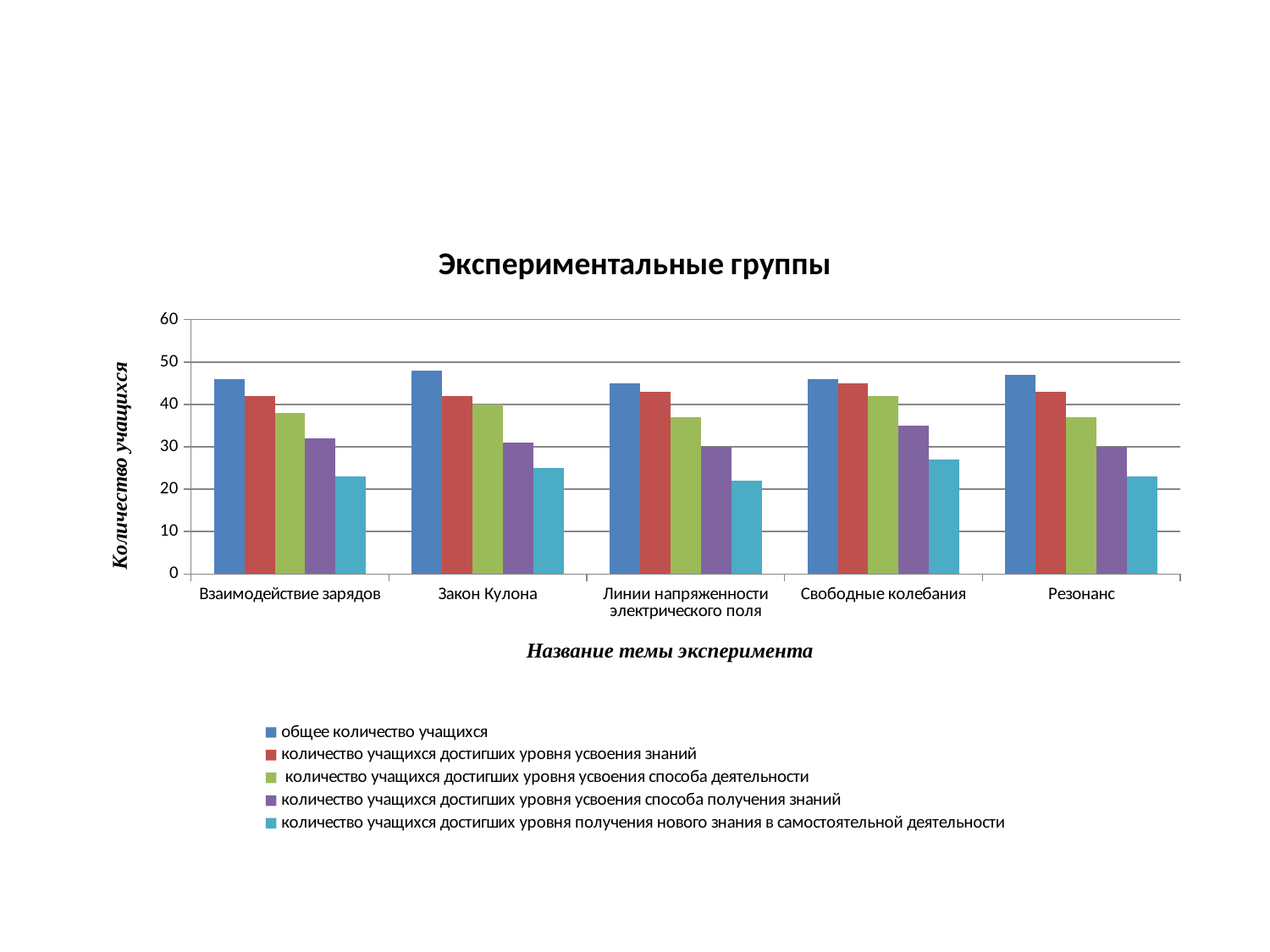
What kind of chart is shown on the slide? bar chart Is the value of 'количество учащихся достигших уровня получения нового знания в самостоятельной деятельности' for 'Линии напряженности электрического поля' greater or less than 30? less Is the value of 'количество учащихся достигших уровня усвоения способа получения знаний' for 'Взаимодействие зарядов' greater or less than 30? greater For the series 'количество учащихся достигших уровня получения нового знания в самостоятельной деятельности', which is larger: 'Свободные колебания' or 'Линии напряженности электрического поля'? Свободные колебания Within the 'Резонанс' group, do the bars rise or fall from left to right across the series? fall Is the value of 'количество учащихся достигших уровня усвоения знаний' for 'Резонанс' greater or less than 40? greater How many experiment topics (categories) are shown on the x axis? 5 What is the title of the chart? Экспериментальные группы How many series does the legend list? 5 What is the label of the vertical axis? Количество учащихся Which topic has the highest value for 'количество учащихся достигших уровня получения нового знания в самостоятельной деятельности'? Свободные колебания